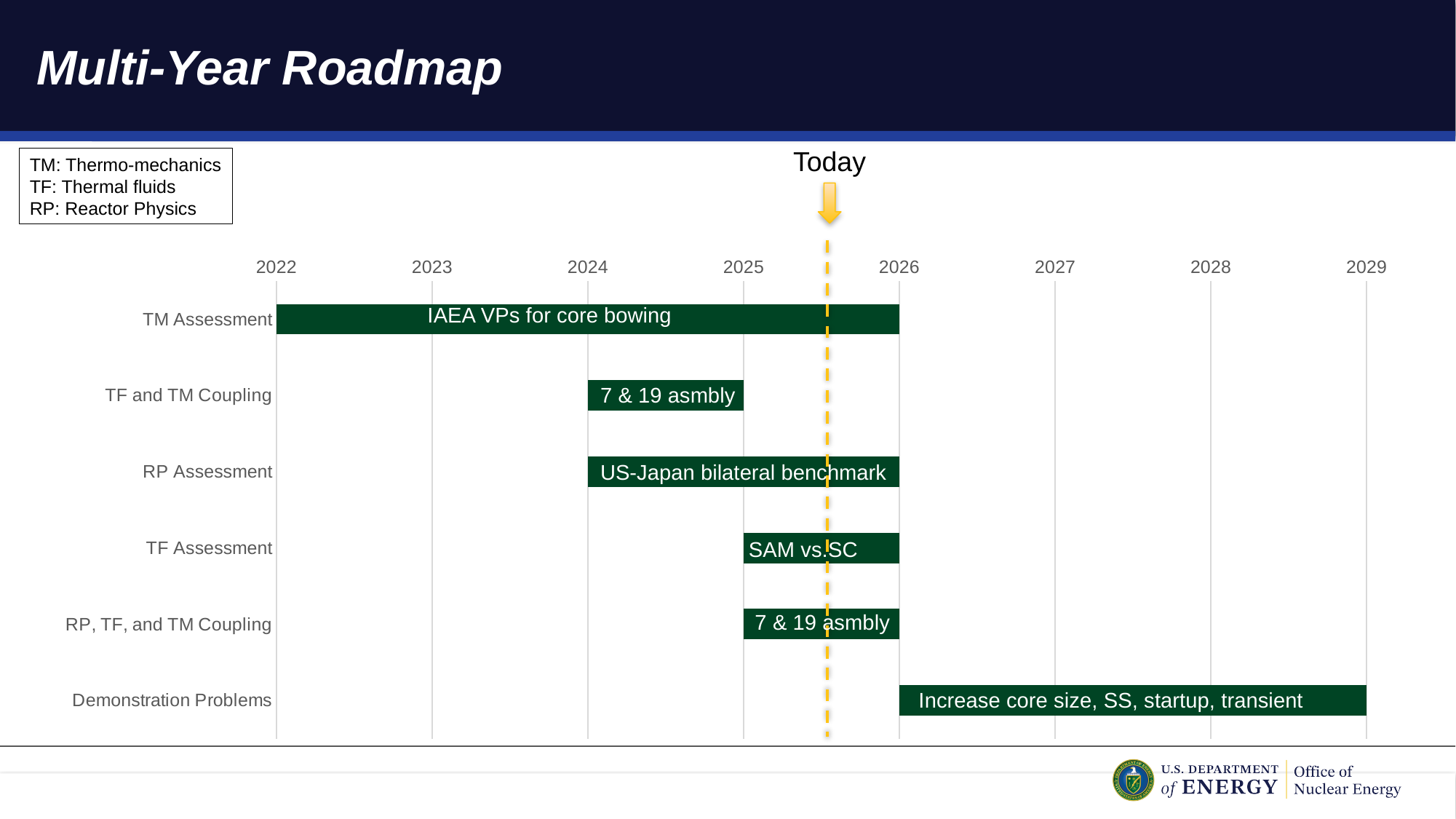
What kind of chart is shown on the slide? Gantt chart (horizontal bar chart) How many years does the RP Assessment bar span? 2 What label is printed on the TF Assessment bar? SAM vs. SC In which year does the TM Assessment bar start? 2022 Which task row has the longest bar? TM Assessment Which bar is longer, TM Assessment or TF Assessment? TM Assessment In which year does the Demonstration Problems bar end? 2029 How many task rows are shown in the roadmap chart? 6 How many years does the Demonstration Problems bar span? 3 In which year does the TM Assessment bar end? 2026 What is the title of the slide containing the roadmap chart? Multi-Year Roadmap In which year does the TF and TM Coupling bar start? 2024